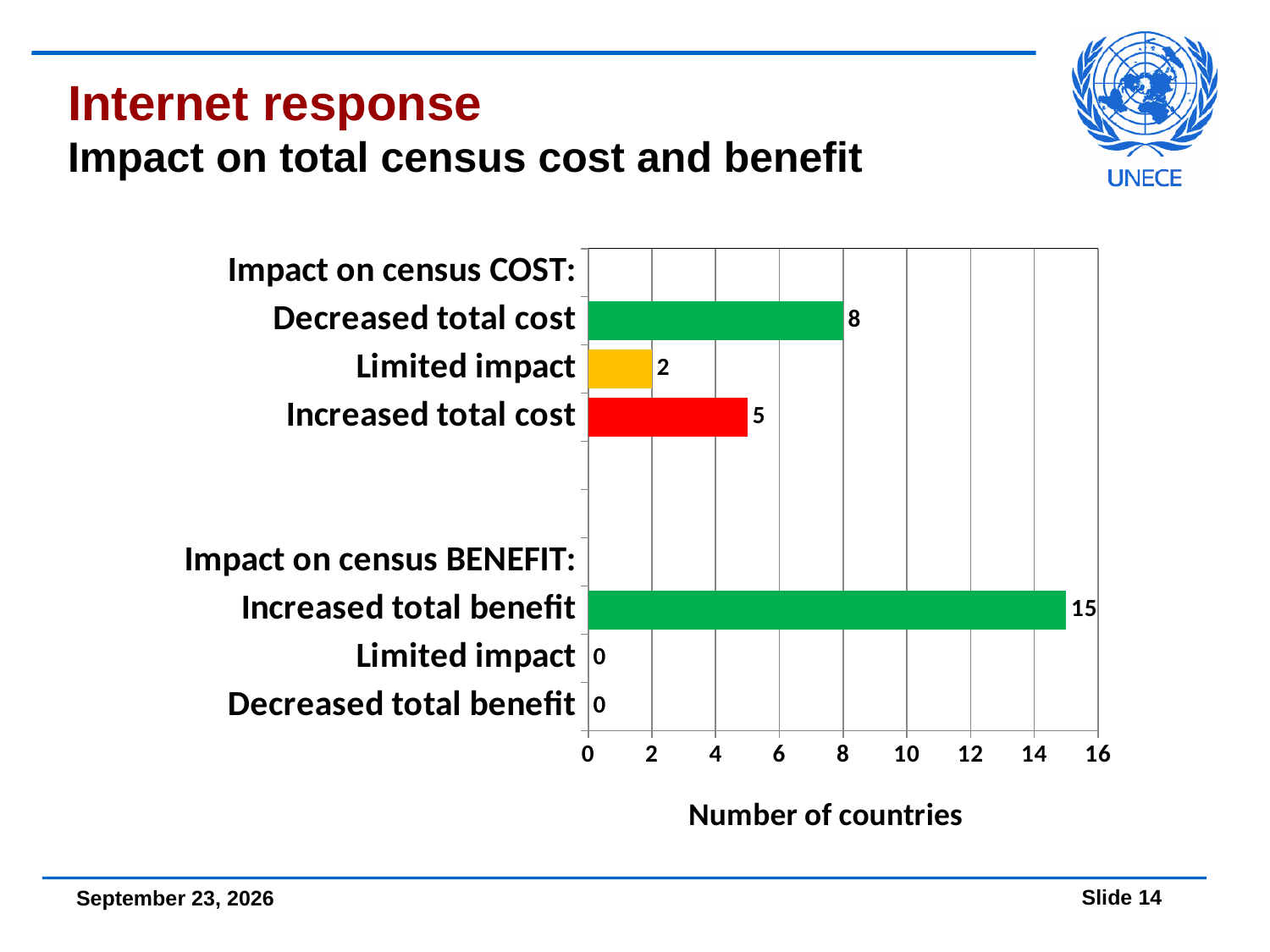
What is the label of the horizontal axis? Number of countries What colour is the bar for Limited impact on census cost? Yellow How many countries reported an increased total benefit? 15 What is the difference between the number of countries reporting increased total benefit and decreased total cost? 7 Which category has the highest number of countries? Increased total benefit Which is larger: the number of countries reporting decreased total cost or increased total cost? Decreased total cost What type of chart is shown on the slide? Bar chart How many countries reported a decreased total benefit? 0 How many countries reported a decreased total cost? 8 How many countries reported an increased total cost? 5 How many countries reported limited impact on census cost? 2 What is the difference between the number of countries reporting decreased total cost and increased total cost? 3